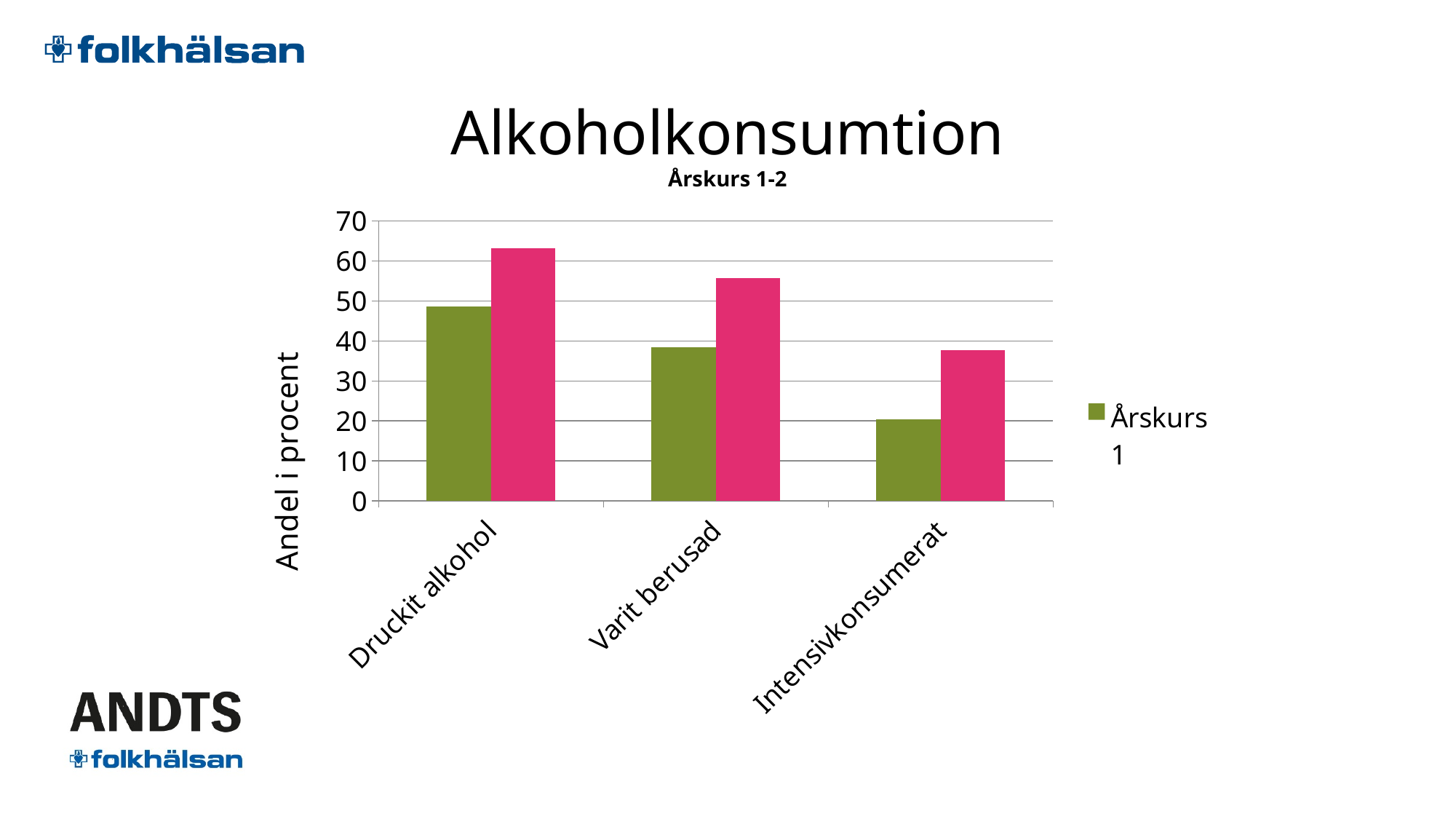
What kind of chart is shown on the slide? bar chart Which category has the highest pink bar? Druckit alkohol Is the pink bar value for Druckit alkohol greater or less than 60? greater How many categories are shown on the x axis of the chart? 3 What is the title printed above the chart's plot area? Årskurs 1-2 What is the label of the vertical axis? Andel i procent For Druckit alkohol, which bar is taller, the green (Årskurs 1) bar or the pink bar? the pink bar Is the green (Årskurs 1) value for Druckit alkohol greater or less than 50? less Which category has the lowest green (Årskurs 1) bar? Intensivkonsumerat Is the pink bar value for Varit berusad greater or less than 50? greater Do the green (Årskurs 1) values rise or fall from Druckit alkohol to Intensivkonsumerat? fall